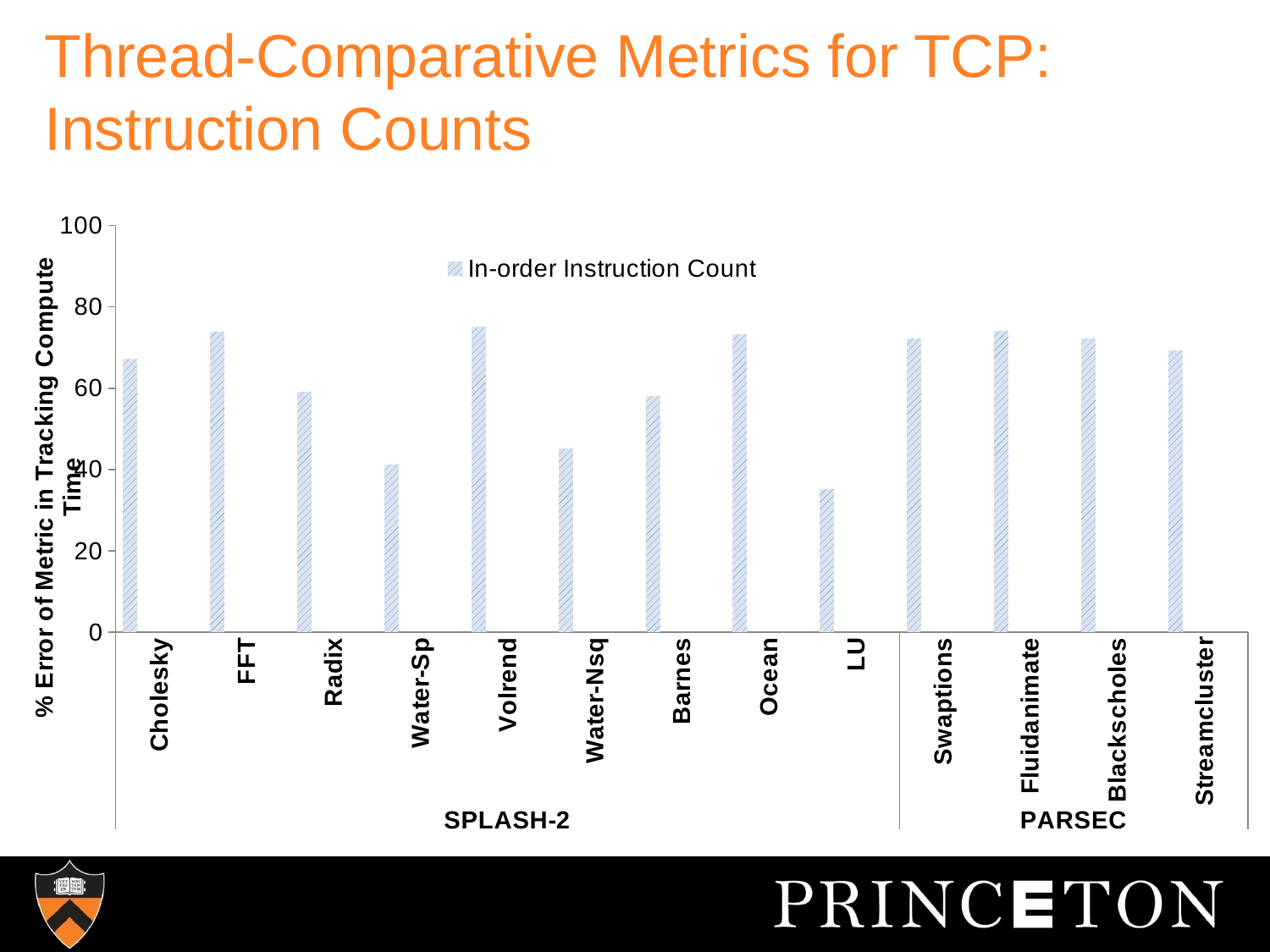
Which has the larger value, Radix or Water-Sp? Radix Is the value for Cholesky greater or less than 60? greater How many benchmark categories are plotted on the x axis? 13 Which has the larger value, Cholesky or LU? Cholesky Is the value for Ocean greater or less than 60? greater What kind of chart is shown on the slide? bar chart What is the name of the series shown in the legend? In-order Instruction Count Is the value for Water-Nsq greater or less than 60? less How many benchmarks belong to the PARSEC group on the x axis? 4 How many series does the legend list? 1 Which benchmark has the lowest In-order Instruction Count error? LU